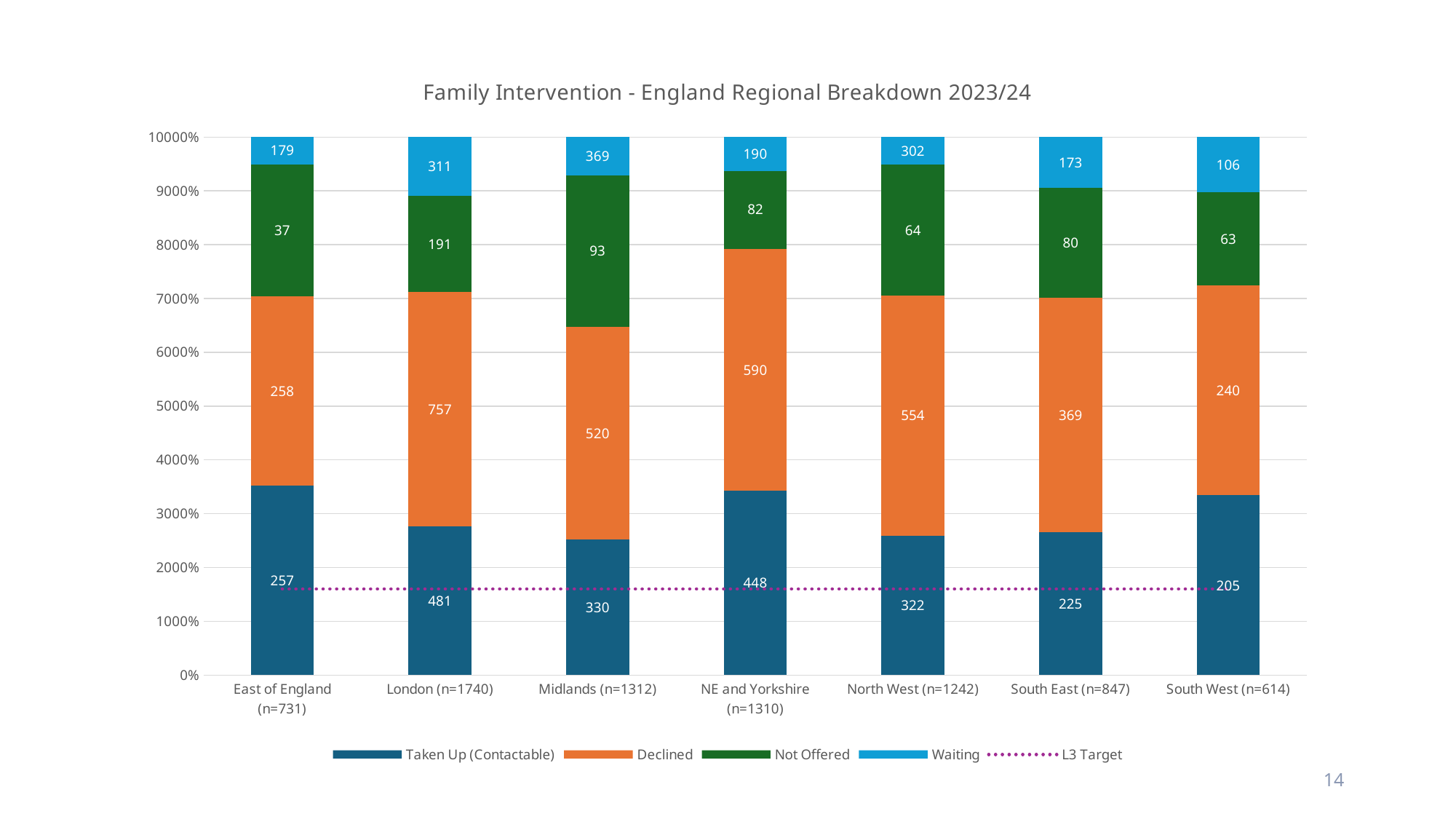
What is the Waiting value for Midlands (n=1312)? 369 Which region has the highest Declined value? London (n=1740) What is the title of the chart? Family Intervention - England Regional Breakdown 2023/24 What is the total of the four labelled segments for East of England (n=731)? 731 How many entries does the legend list? 5 What kind of chart is this? Stacked bar chart Which region has the lowest Not Offered value? East of England (n=731) How many regions are shown on the x axis? 7 What is the Declined value for London (n=1740)? 757 What is the difference between the Taken Up (Contactable) values for London (n=1740) and South West (n=614)? 276 What is the Not Offered value for NE and Yorkshire (n=1310)? 82 Which has the larger Waiting value, Midlands (n=1312) or London (n=1740)? Midlands (n=1312)